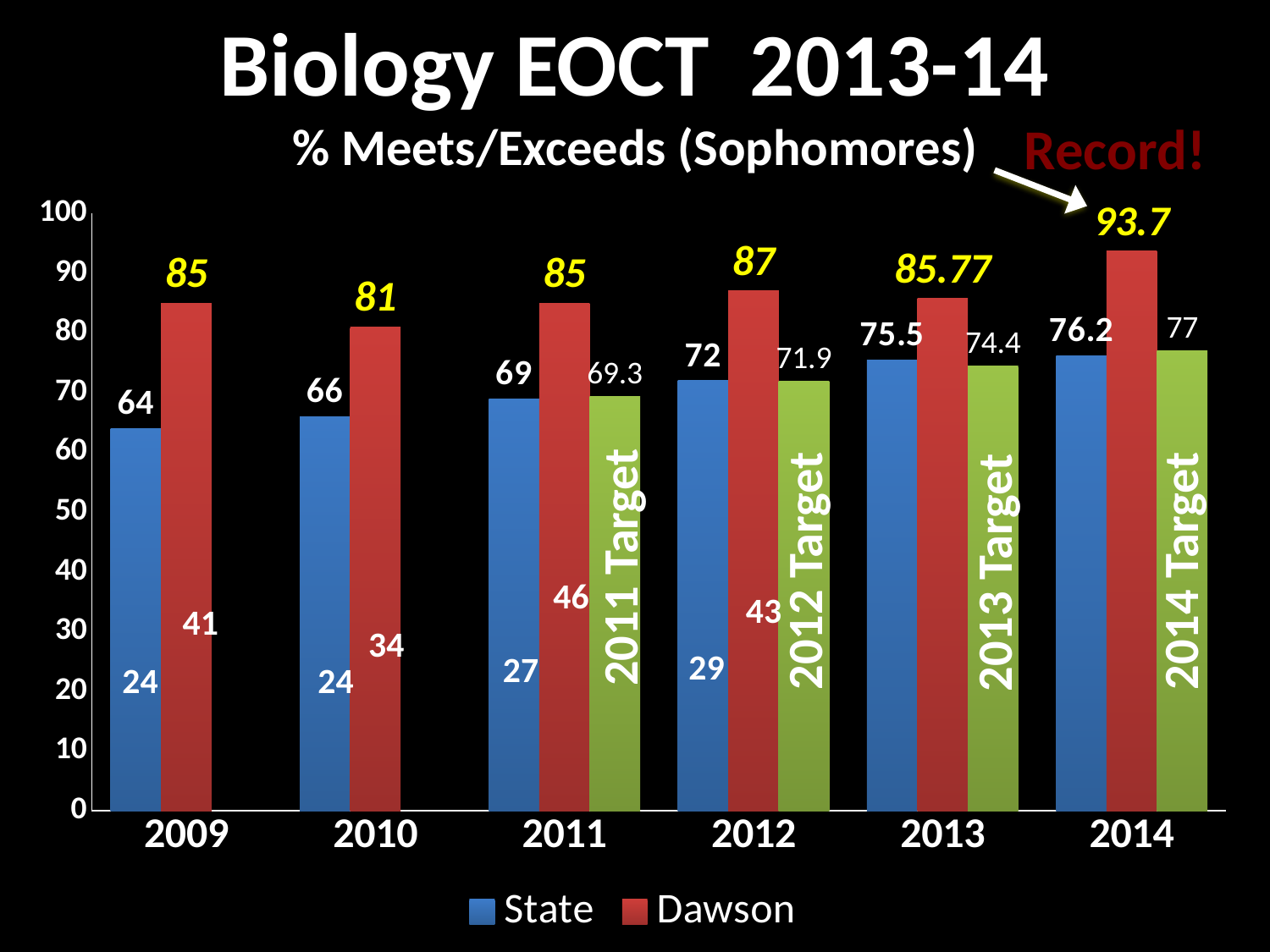
Which is larger in 2010, the State value or the Dawson value? Dawson Do the State values rise or fall from 2009 to 2014? rise In which year is the State value lowest? 2009 What is the difference between the Dawson and State values in 2009? 21 What is the 2012 Target value shown on the green bar? 71.9 In which year is the Dawson value highest? 2014 How many series does the legend list? 2 How many years are shown on the x axis? 6 What kind of chart is shown on the slide? bar chart What is the Dawson value for 2014? 93.7 What is the State value for 2013? 75.5 Is the Dawson value for 2014 greater or less than 90? greater